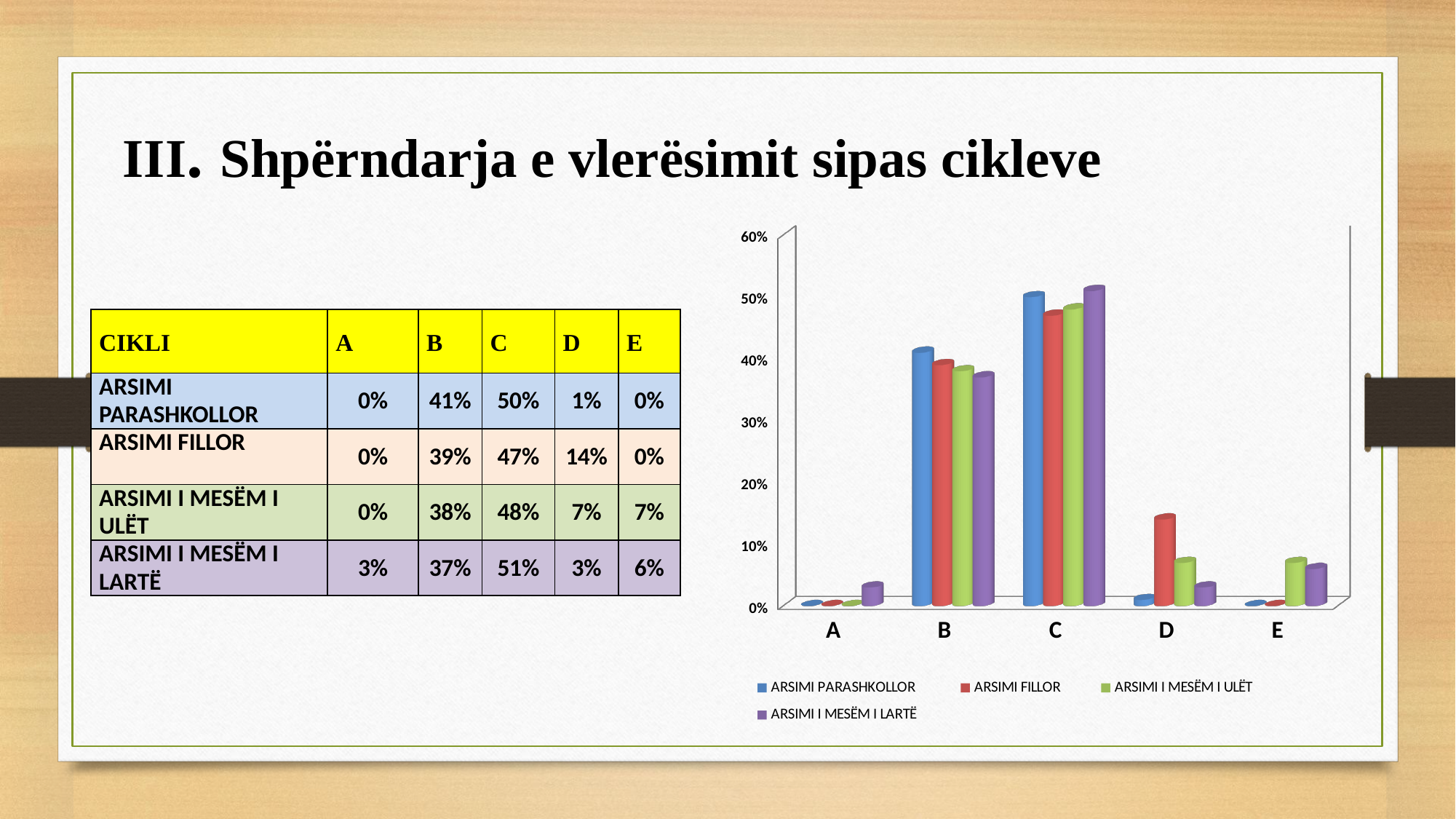
Which series has the highest value in category C? ARSIMI I MESËM I LARTË What is the value for ARSIMI I MESËM I LARTË in category B? 37% What is the difference between the ARSIMI PARASHKOLLOR value and the ARSIMI I MESËM I LARTË value in category B? 4% Is the value for ARSIMI FILLOR in category C greater or less than 40%? greater What is the value for ARSIMI FILLOR in category D? 14% Which colour represents ARSIMI FILLOR in the chart? red What is the value for ARSIMI PARASHKOLLOR in category C? 50% Which is larger for ARSIMI I MESËM I ULËT: the value in category B or the value in category C? C What kind of chart is shown on the slide? bar chart How many categories are shown on the x axis of the chart? 5 Which series has the highest value in category D? ARSIMI FILLOR How many series does the chart legend list? 4